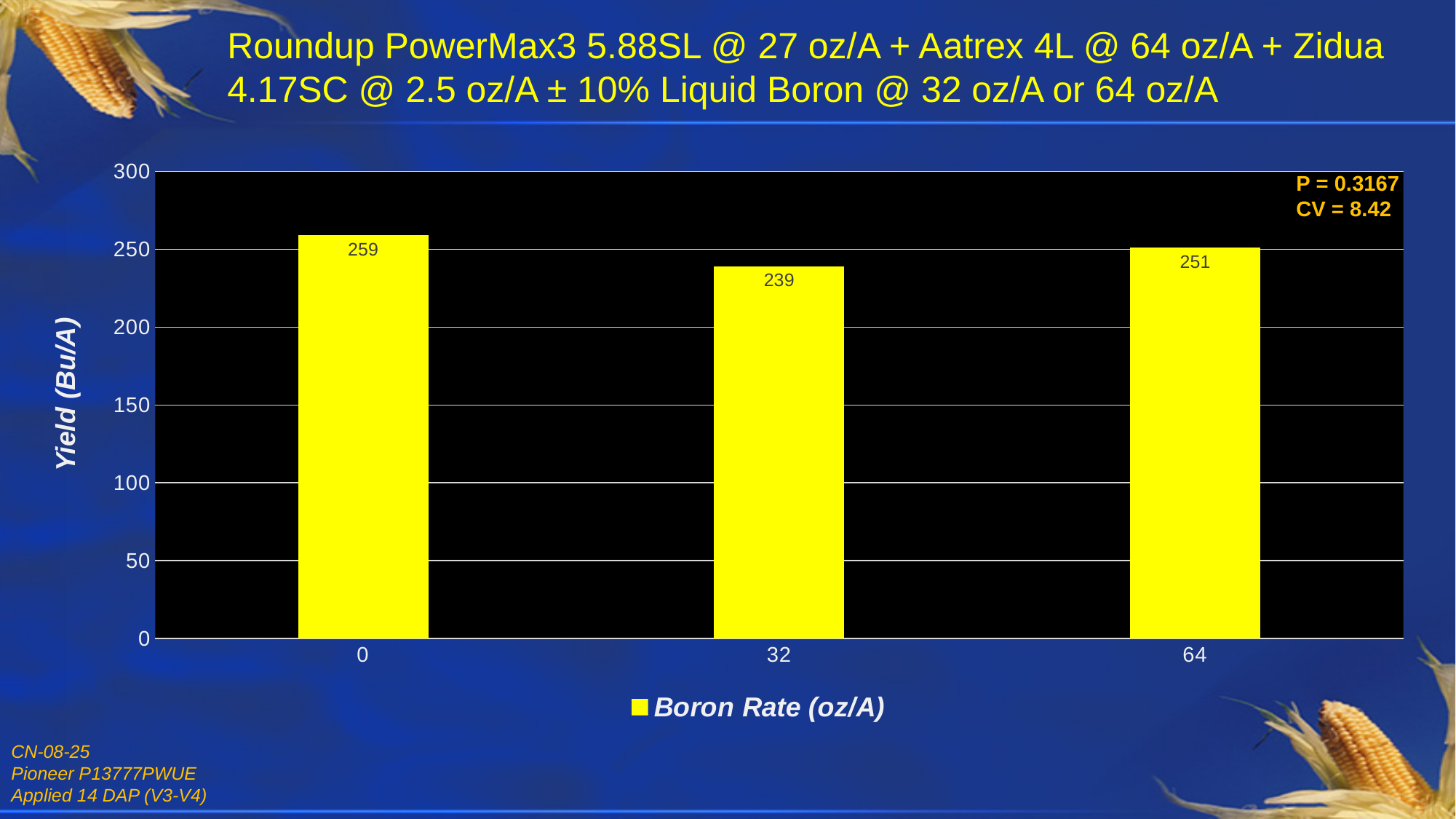
What is the difference in yield between the 64 oz/A and 32 oz/A boron rates? 12 What is the yield (Bu/A) for a boron rate of 32 oz/A? 239 What is the yield (Bu/A) for a boron rate of 0 oz/A? 259 What kind of chart is shown on the slide? bar chart What is the P value shown on the chart? 0.3167 What is the difference in yield between the 0 oz/A and 32 oz/A boron rates? 20 Which has a higher yield, the 0 oz/A or the 64 oz/A boron rate? 0 oz/A Which boron rate has the lowest yield? 32 Which boron rate has the highest yield? 0 Is the yield for the 32 oz/A boron rate greater or less than 250? less How many boron rate categories are shown on the chart? 3 What is the yield (Bu/A) for a boron rate of 64 oz/A? 251